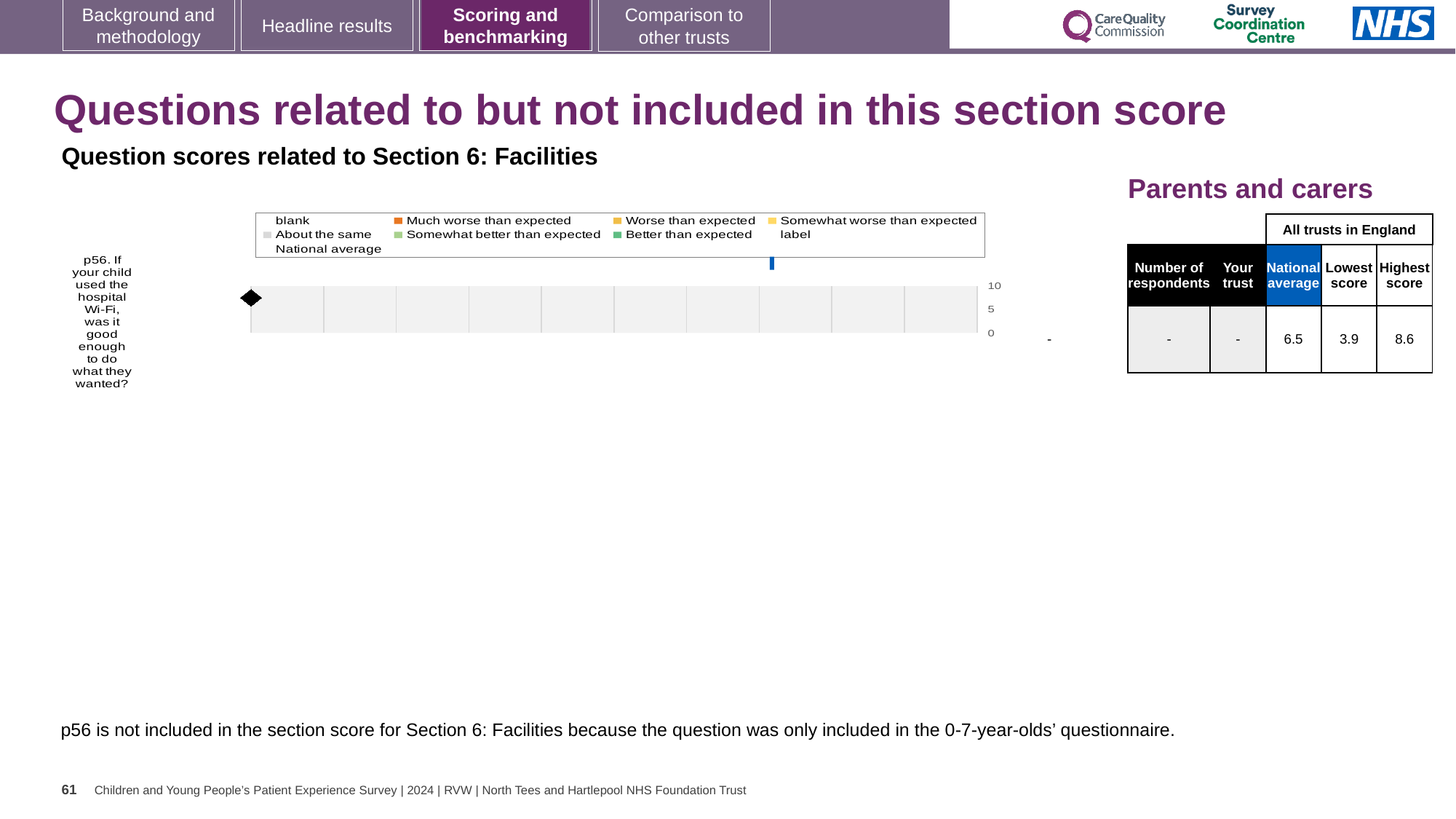
What is the lowest score across all trusts in England for p56? 3.9 What is the national average score for p56 in the Parents and carers table? 6.5 What colour is the legend entry 'Much worse than expected'? orange Is the national average for p56 greater or less than 5? greater Which is larger for p56, the national average or the lowest score? national average How many questions are plotted on the chart? 1 What is the difference between the national average and the lowest score for p56? 2.6 What is shown as the score for 'Your trust' for p56? - What kind of chart is shown for question p56? bar chart What is the difference between the highest score and the lowest score for p56? 4.7 What is the highest value shown on the chart's score axis? 10 What is the highest score across all trusts in England for p56? 8.6